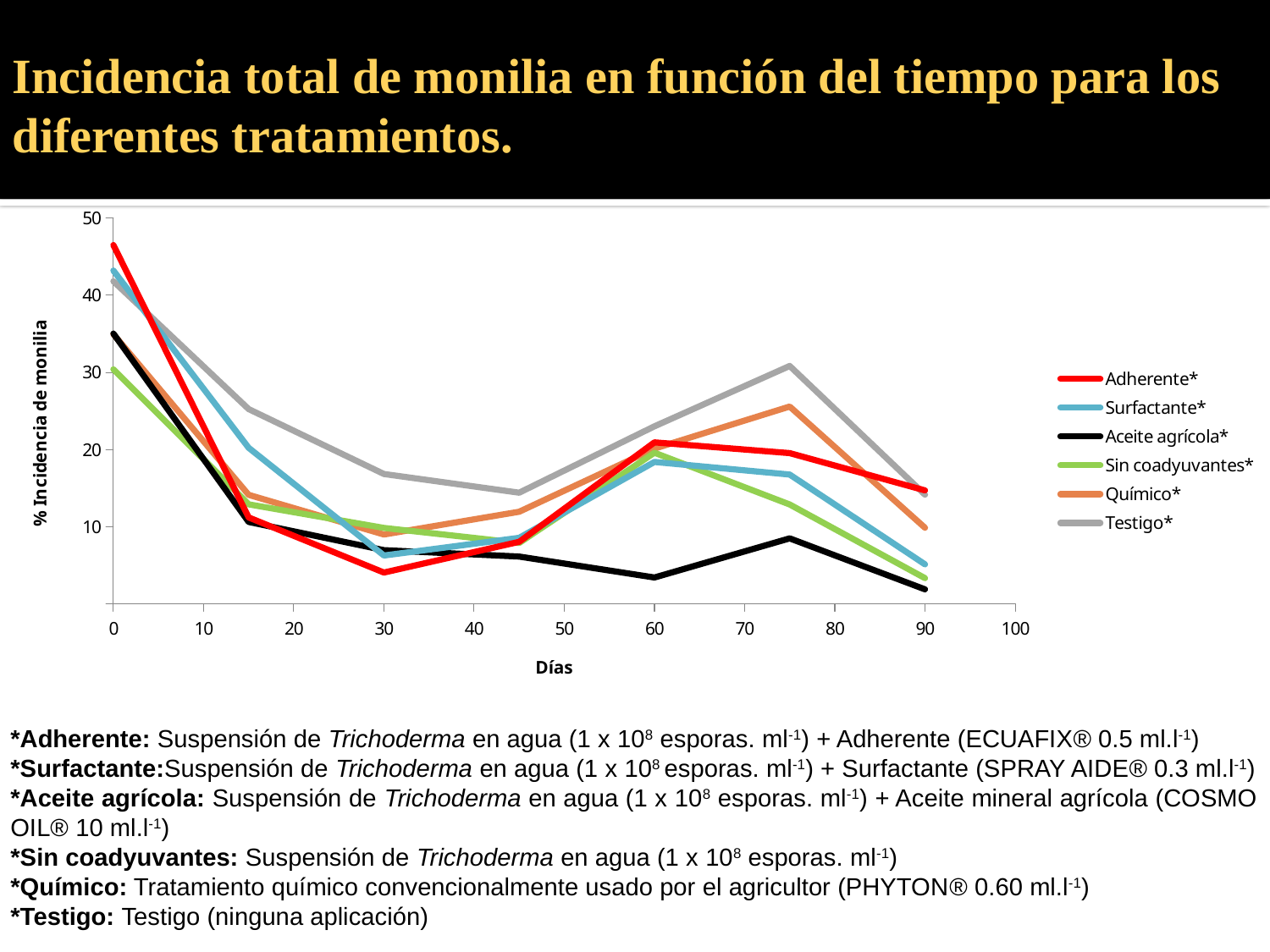
What kind of chart is shown on the slide? Line chart What is the title of the x axis? Días Which treatment has the lowest incidence at day 0? Sin coadyuvantes* Is the value for Aceite agrícola* at day 60 greater or less than 10? less What is the title of the y axis? % Incidencia de monilia Which treatment has the highest incidence at day 75? Testigo* Which treatment has the lowest incidence at day 90? Aceite agrícola* Which treatment has the highest incidence at day 0? Adherente* Does the Testigo* line rise or fall between day 45 and day 75? rise Is the value for Adherente* at day 0 greater or less than 40? greater How many series does the legend list? 6 Is the value for Testigo* at day 75 greater or less than 20? greater